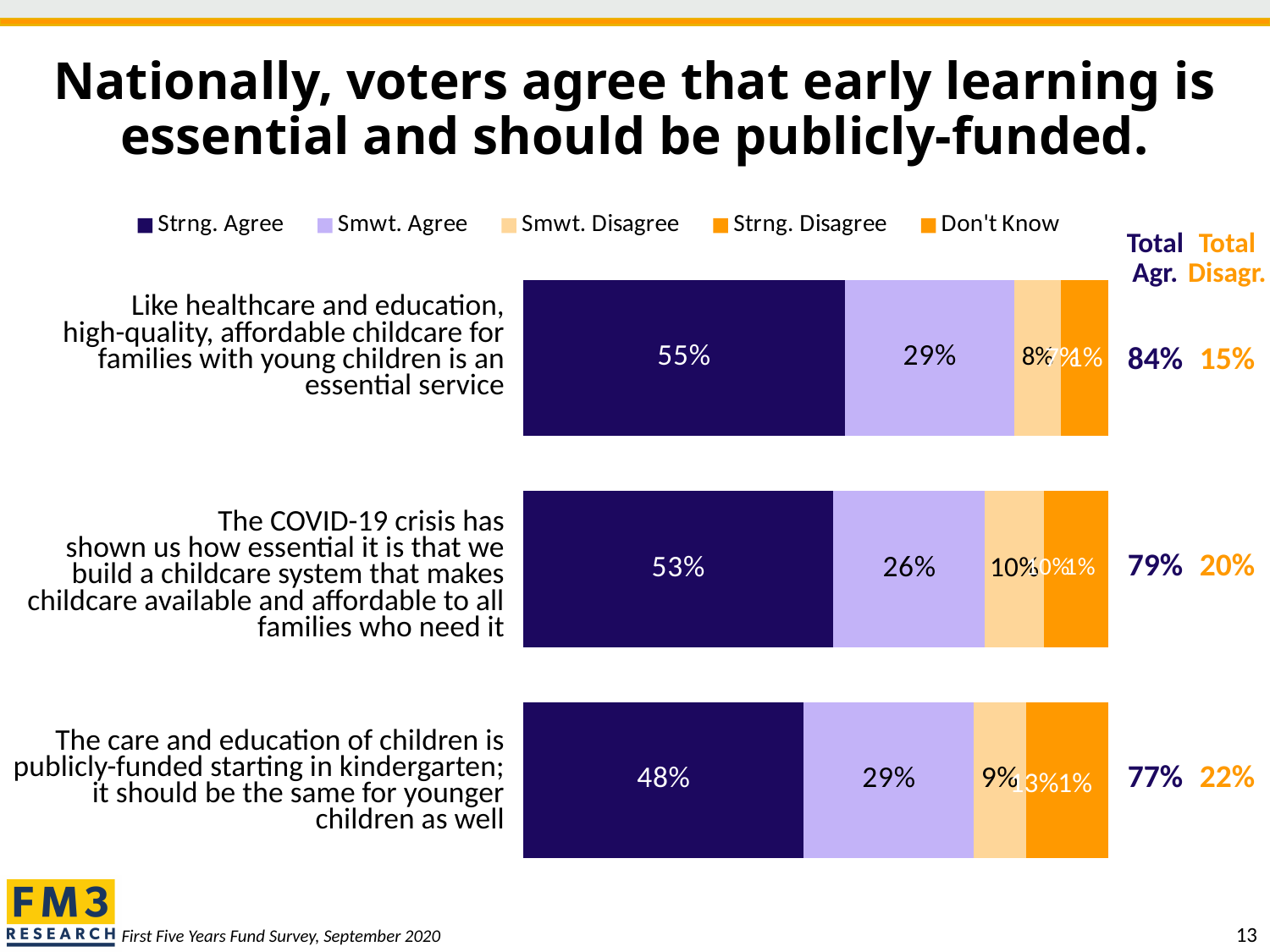
What is the Total Disagr. figure for the statement about publicly-funded care and education for younger children? 22% How many percentage points higher is the Strng. Agree value for the essential service statement than for the publicly-funded kindergarten statement? 7 percentage points What percentage strongly agree that the care and education of younger children should be publicly-funded like kindergarten? 48% What percentage of voters strongly agree that high-quality, affordable childcare is an essential service like healthcare and education? 55% Which statement has the highest Strng. Agree percentage? Like healthcare and education, high-quality, affordable childcare for families with young children is an essential service How many statements are shown in the chart? 3 Which statement has the lowest Total Agr. figure? The care and education of children is publicly-funded starting in kindergarten; it should be the same for younger children as well What is the Smwt. Disagree value for the COVID-19 crisis statement? 10% What is the Total Agr. figure for the COVID-19 crisis statement? 79% What share somewhat agree with the statement that the COVID-19 crisis has shown how essential a childcare system is? 26% How many response categories does the legend list? 5 Is the Strng. Agree value larger for the COVID-19 crisis statement or for the publicly-funded kindergarten statement? The COVID-19 crisis statement